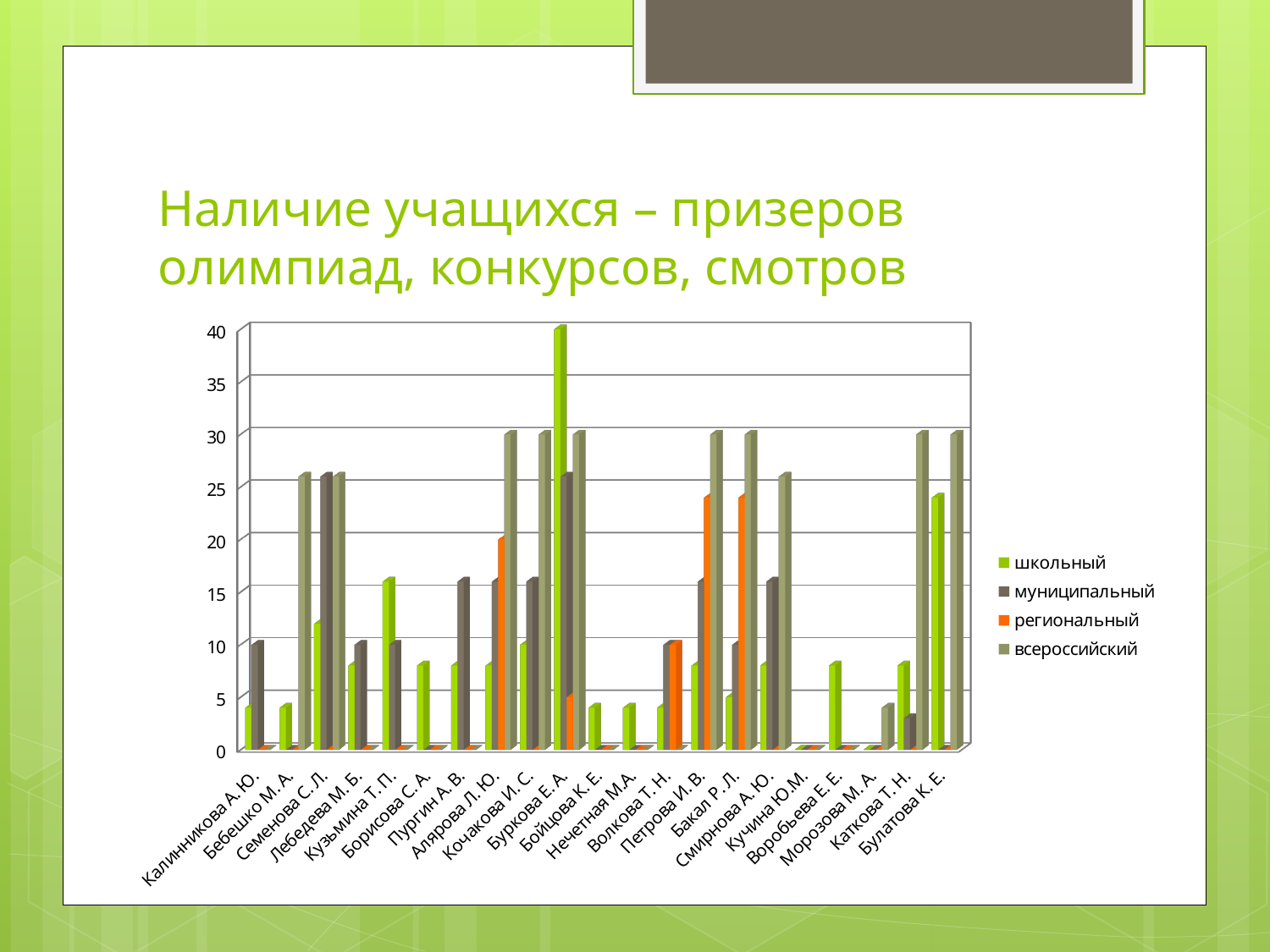
Which series is shown in orange in the legend? региональный Which category has the tallest bar in the chart? Буркова Е. А. Is the школьный value for Булатова К. Е. greater or less than 20? greater Is the региональный value for Петрова И. В. greater or less than 20? greater Is the школьный value for Калинникова А. Ю. greater or less than 5? less What is the title of the slide? Наличие учащихся – призеров олимпиад, конкурсов, смотров How many series does the legend list? 4 How many categories (people) are shown along the x axis? 21 What kind of chart is shown on the slide? bar chart Which is larger: the школьный value for Буркова Е. А. or the школьный value for Булатова К. Е.? Буркова Е. А.